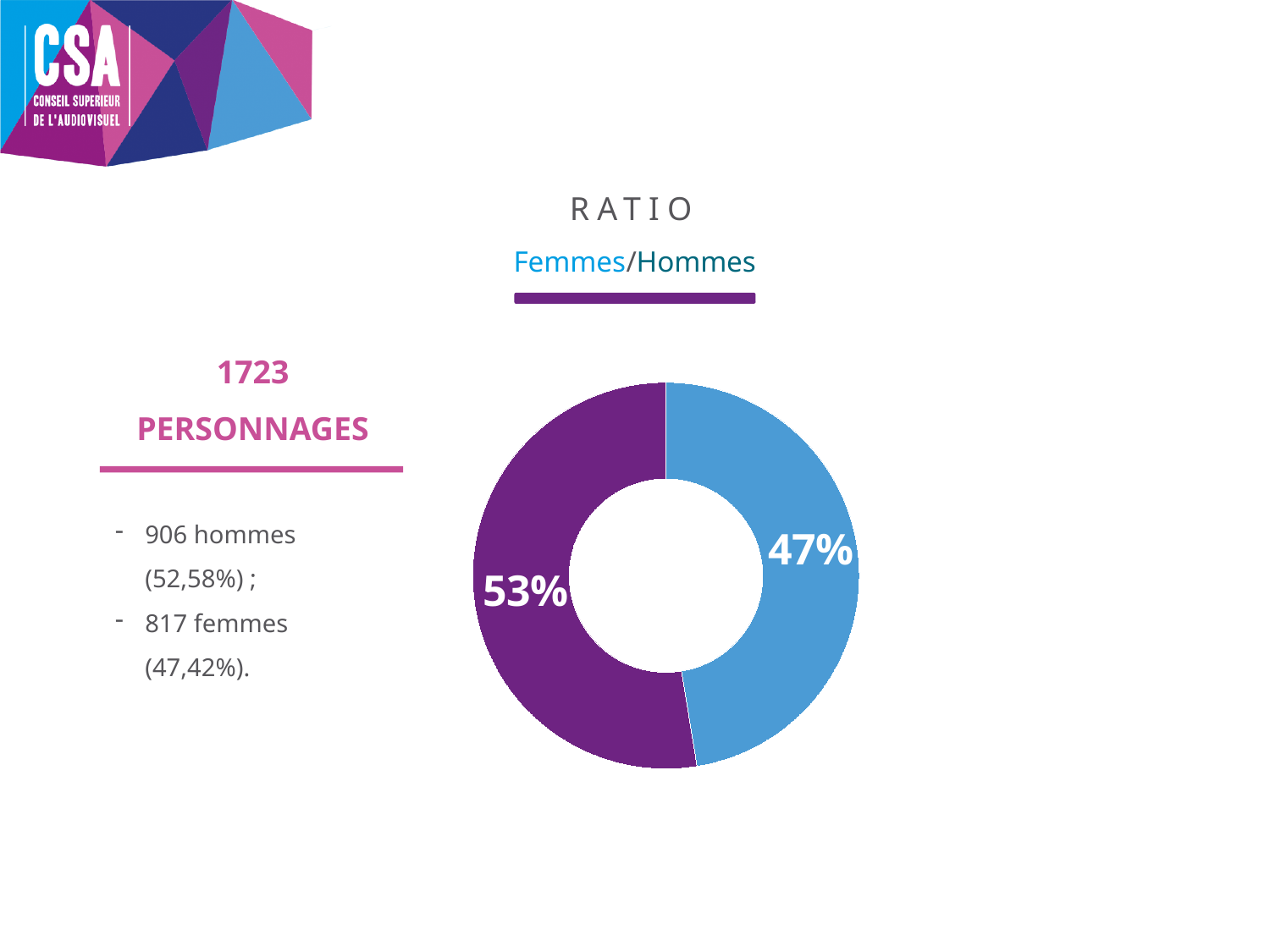
What share of the donut chart is labelled for the blue slice (Femmes)? 47% Which slice of the donut chart is the smallest? Femmes (47%) What kind of chart is shown on the slide? Pie chart (donut) Which slice of the donut chart is the largest? Hommes (53%) How many slices does the donut chart have? 2 Is the share of the Hommes slice greater or less than 50%? greater Which is larger in the donut chart, the Femmes slice or the Hommes slice? Hommes What is the title of the chart? RATIO Femmes/Hommes What colour is the slice labelled 53%? Purple What is the difference in percentage points between the Hommes slice and the Femmes slice? 6 percentage points What is the total of the two slice percentages shown on the donut chart? 100% What share of the donut chart is labelled for the purple slice (Hommes)? 53%